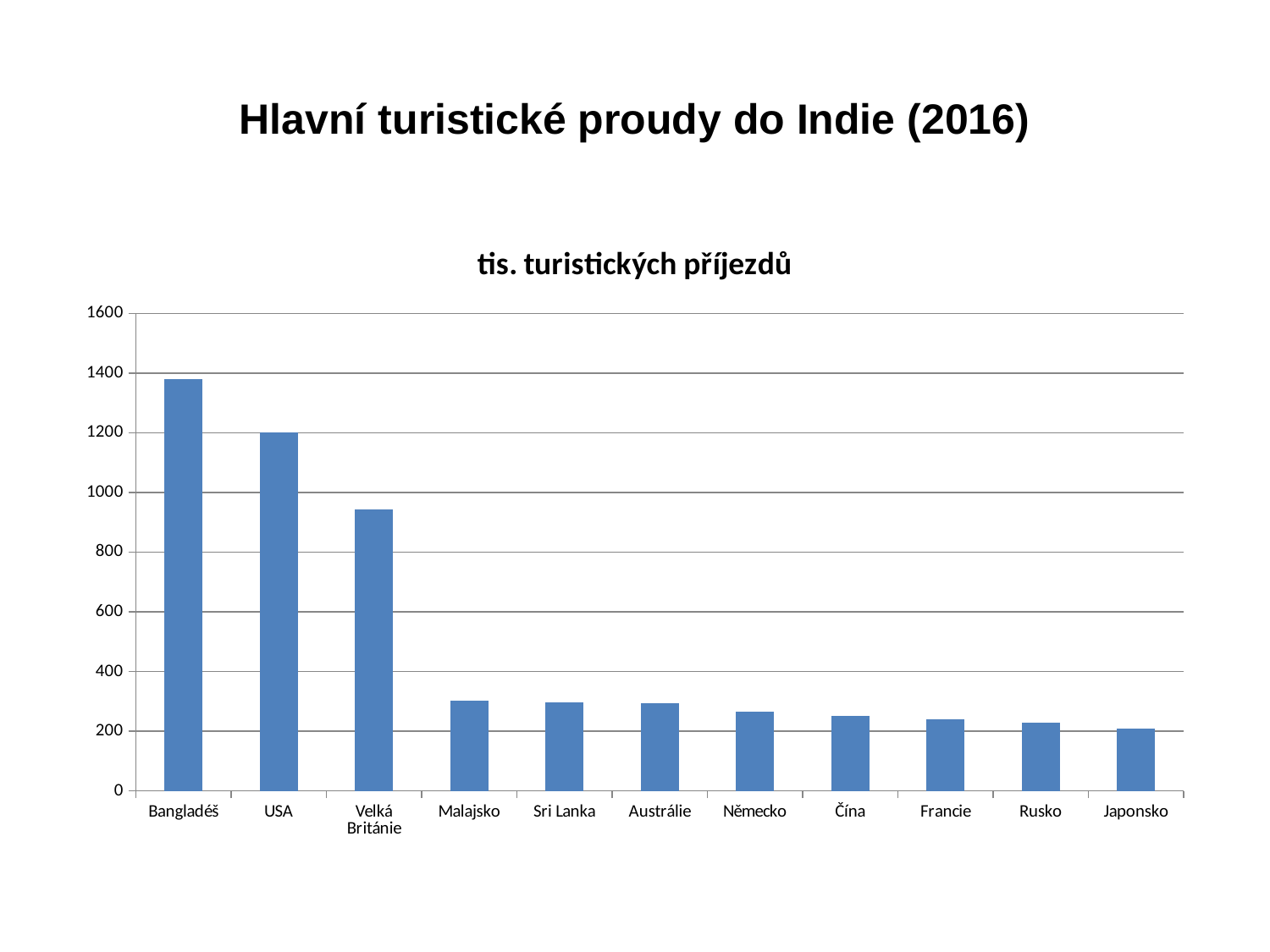
What is the title of the chart? tis. turistických příjezdů Which has a larger value, Bangladéš or USA? Bangladéš Which country has the lowest value in the chart? Japonsko Is the value for Malajsko greater or less than 200? greater Do the values rise or fall from left to right along the x axis? fall Which has a larger value, Velká Británie or Malajsko? Velká Británie What kind of chart is shown on the slide? bar chart Is the value for Bangladéš greater or less than 1200? greater Is the value for USA greater or less than 1400? less Which country has the highest value in the chart? Bangladéš How many countries are shown on the x axis of the chart? 11